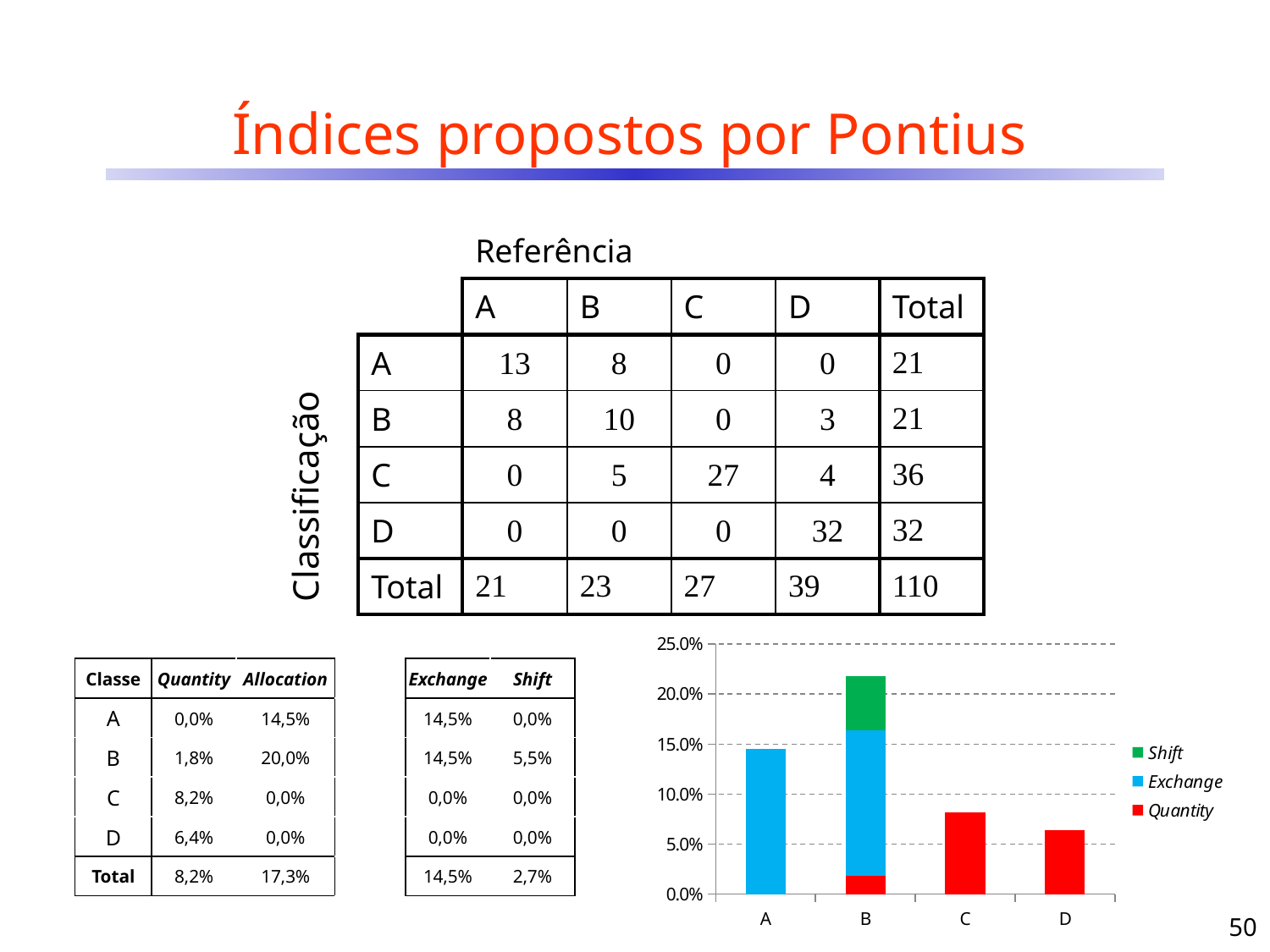
Is the bar for D greater or less than 5.0%? greater Which series is shown in red in the chart's legend? Quantity Which category has the tallest stacked bar in the chart? B How many series does the chart's legend list? 3 How many categories are shown on the x axis of the chart? 4 Which category is the only one with a green (Shift) segment in its bar? B Is the bar for C greater or less than 10.0%? less Which bar is taller in the chart, C or D? C What kind of chart is shown on the slide? stacked bar chart Is the total stacked bar for A greater or less than 10.0%? greater Which category has the shortest stacked bar in the chart? D